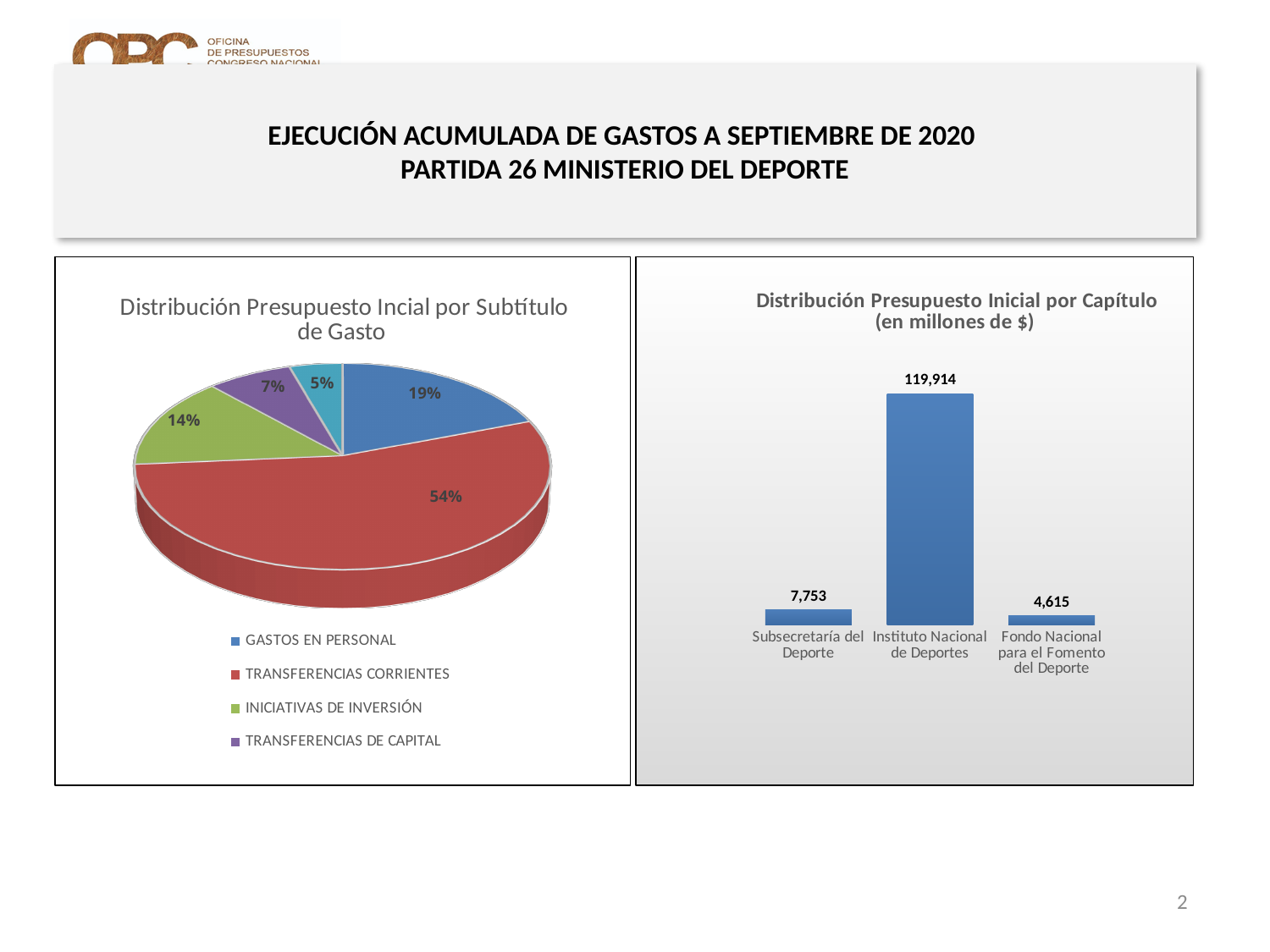
In the bar chart 'Distribución Presupuesto Inicial por Capítulo', what is the value for Instituto Nacional de Deportes? 119,914 In the pie chart 'Distribución Presupuesto Incial por Subtítulo de Gasto', how many entries does the legend list? 4 In the bar chart 'Distribución Presupuesto Inicial por Capítulo', which category has the highest value? Instituto Nacional de Deportes In the bar chart 'Distribución Presupuesto Inicial por Capítulo', which is larger: Subsecretaría del Deporte or Fondo Nacional para el Fomento del Deporte? Subsecretaría del Deporte In the bar chart 'Distribución Presupuesto Inicial por Capítulo', what is the value for Subsecretaría del Deporte? 7,753 What kind of chart is the chart on the right side of the slide? Bar chart In the pie chart 'Distribución Presupuesto Incial por Subtítulo de Gasto', what share does GASTOS EN PERSONAL have? 19% In the bar chart 'Distribución Presupuesto Inicial por Capítulo', what is the value for Fondo Nacional para el Fomento del Deporte? 4,615 In the bar chart 'Distribución Presupuesto Inicial por Capítulo', what is the difference between Instituto Nacional de Deportes and Subsecretaría del Deporte? 112,161 In the bar chart 'Distribución Presupuesto Inicial por Capítulo', how many categories are shown? 3 In the bar chart 'Distribución Presupuesto Inicial por Capítulo', which category has the lowest value? Fondo Nacional para el Fomento del Deporte In the pie chart 'Distribución Presupuesto Incial por Subtítulo de Gasto', what share does TRANSFERENCIAS CORRIENTES have? 54%